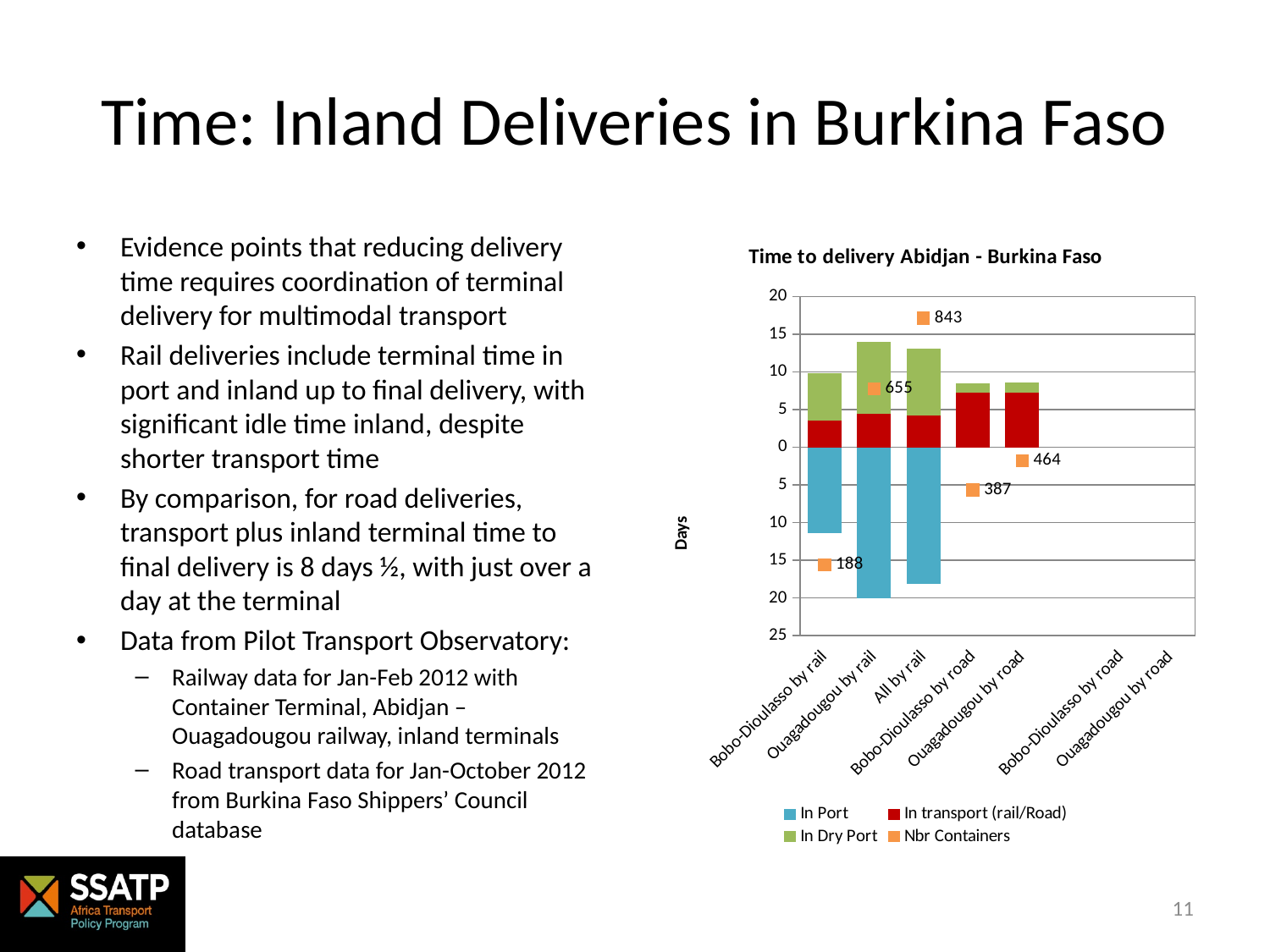
What is the difference between the Nbr Containers values for All by rail and Bobo-Dioulasso by rail? 655 Which has a larger Nbr Containers value, Ouagadougou by rail or Ouagadougou by road? Ouagadougou by rail Which category has the highest Nbr Containers value? All by rail What kind of chart is shown on the slide? bar chart What is the title of the chart? Time to delivery Abidjan - Burkina Faso What is the Nbr Containers value for Bobo-Dioulasso by rail? 188 What is the label on the vertical axis of the chart? Days Is the In transport (rail/Road) value for Bobo-Dioulasso by road greater or less than 5 days? greater What is the Nbr Containers value for All by rail? 843 Which category has the lowest Nbr Containers value? Bobo-Dioulasso by rail What is the Nbr Containers value for Ouagadougou by road? 464 How many series does the chart legend list? 4